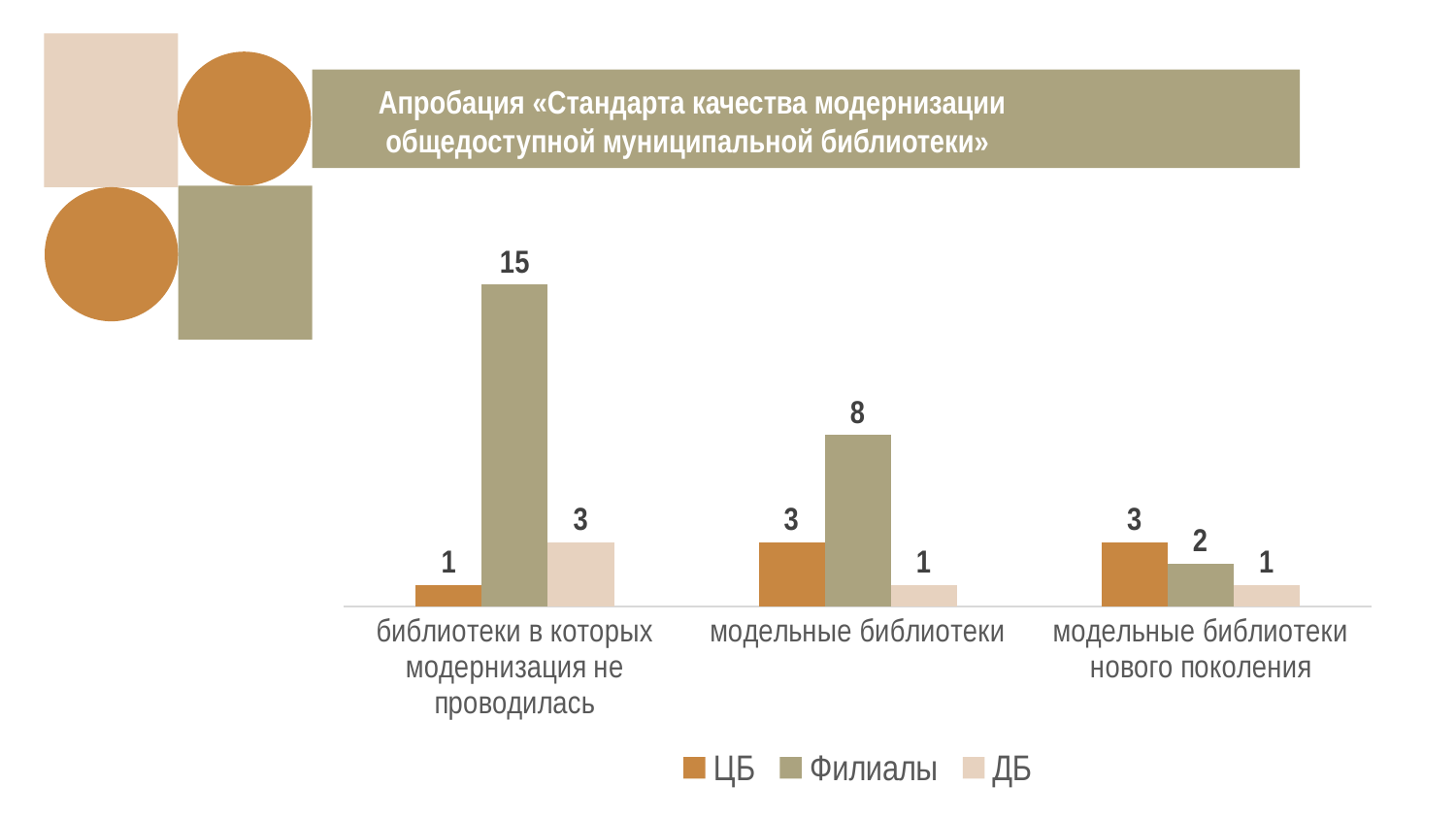
What is the total of the three series for the category 'модельные библиотеки'? 12 Which category has the lowest value for ЦБ? библиотеки в которых модернизация не проводилась What kind of chart is shown on the slide? bar chart How many categories are shown on the x axis? 3 What is the value for Филиалы in the category 'библиотеки в которых модернизация не проводилась'? 15 What is the value for ЦБ in the category 'модельные библиотеки'? 3 What is the difference between the Филиалы values for 'библиотеки в которых модернизация не проводилась' and 'модельные библиотеки'? 7 Which category has the highest value for Филиалы? библиотеки в которых модернизация не проводилась What is the value for ДБ in the category 'модельные библиотеки нового поколения'? 1 Which is larger in the category 'модельные библиотеки нового поколения': ЦБ or Филиалы? ЦБ How many series does the legend list? 3 Which series is shown in orange in the legend? ЦБ